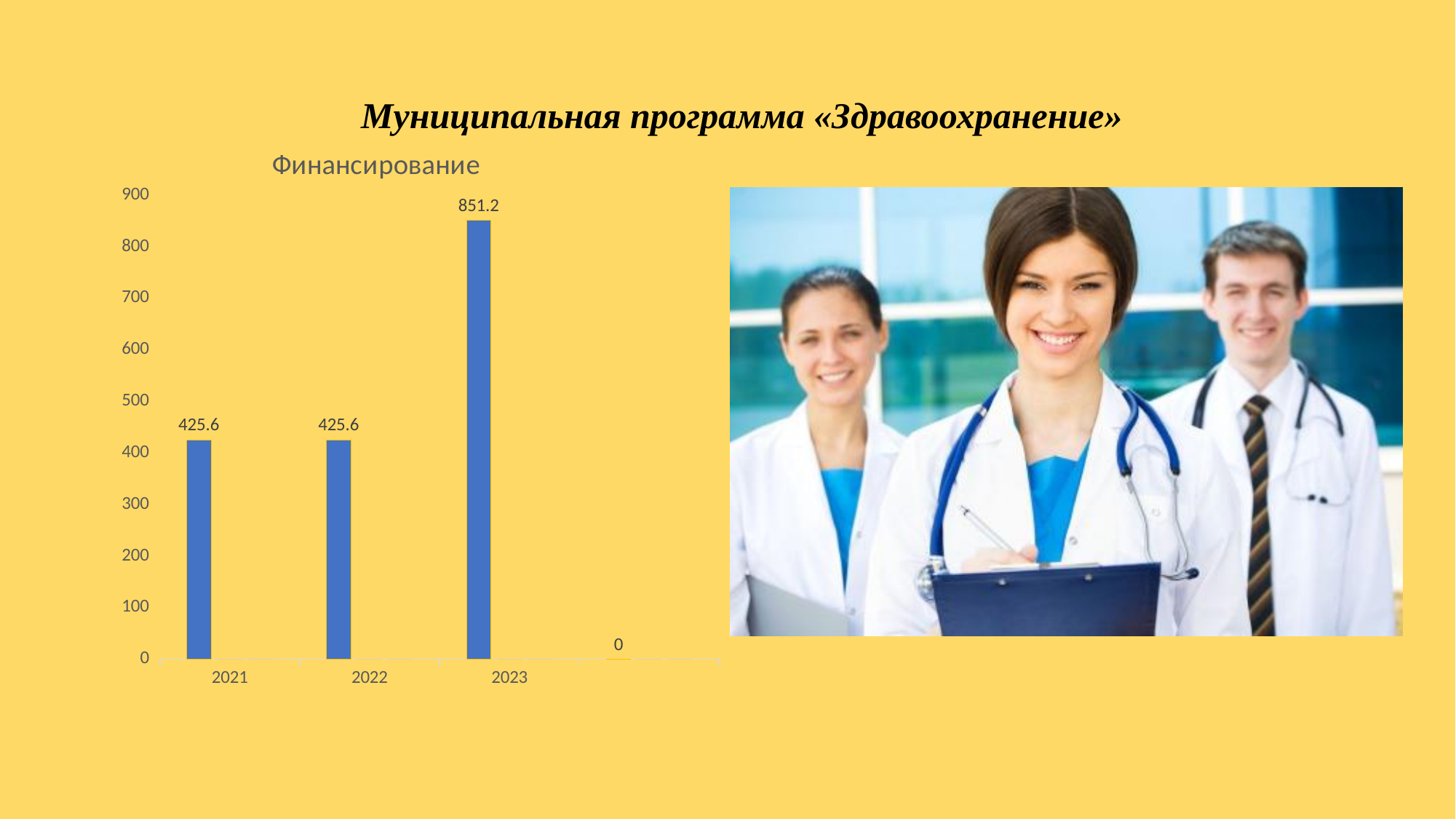
What is the value for 2022 in the Финансирование chart? 425.6 What is the value for 2021 in the Финансирование chart? 425.6 Which year has the highest value in the Финансирование chart? 2023 Which is larger, the value for 2023 or the value for 2021? 2023 What is the value for 2023 in the Финансирование chart? 851.2 What kind of chart is shown on the slide? bar chart Is the value for 2023 greater or less than 800? greater Is the value for 2021 greater or less than 500? less How many years are labeled on the x axis of the chart? 3 What is the difference between the values for 2023 and 2022? 425.6 What is the title of the chart? Финансирование Does the value rise or fall from 2022 to 2023? rise